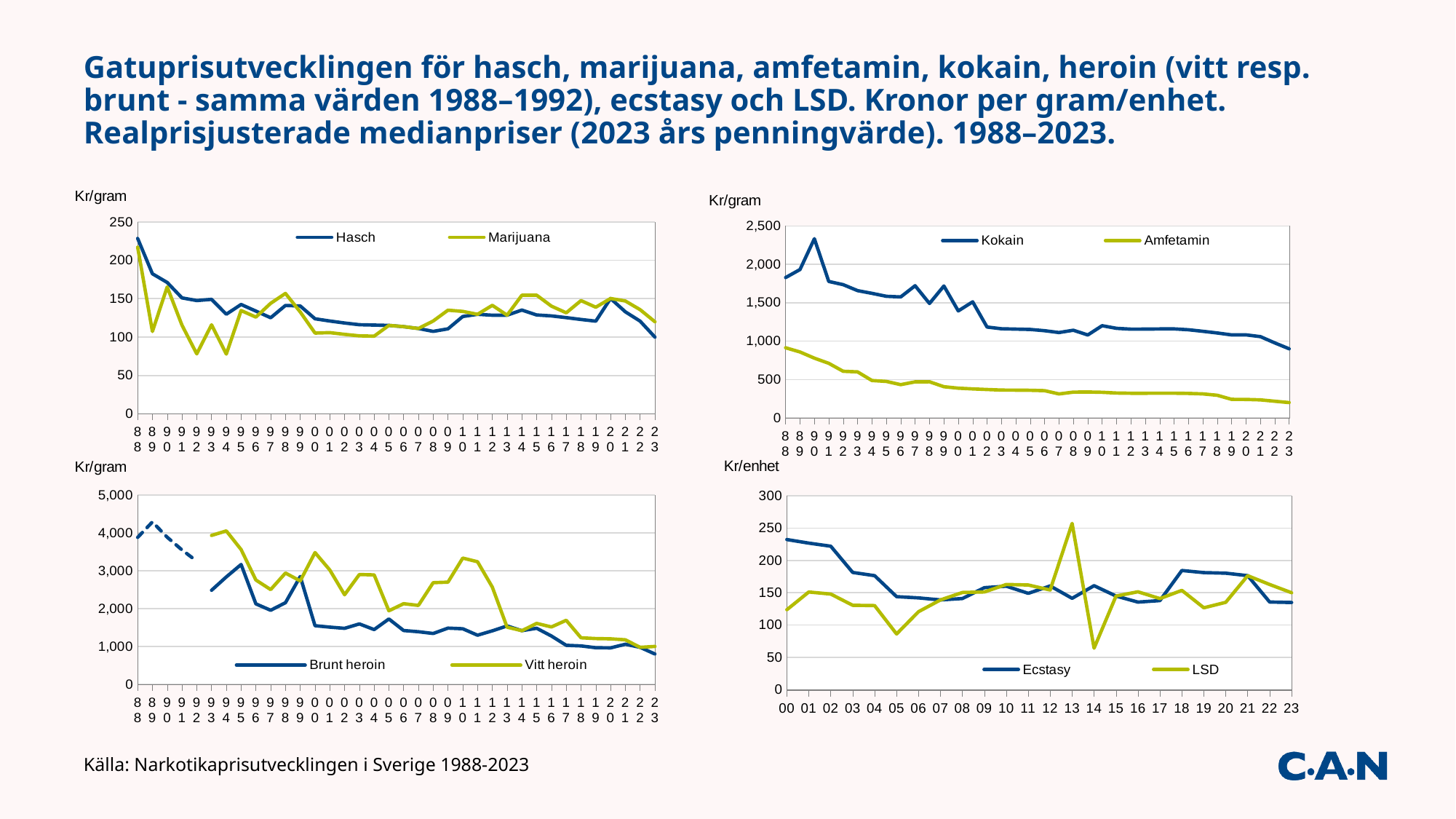
In the bottom-right chart, is the value for LSD in 2014 greater or less than 100? less In the top-left chart, is the value for Hasch in 1988 greater or less than 200? greater In the top-right chart, is the value for Kokain in 1989 greater or less than 2,000? less What kind of chart is the top-left chart showing Hasch and Marijuana? line chart In the top-right chart, which series has the larger value in 1988, Kokain or Amfetamin? Kokain In the bottom-right chart, how many years are plotted along the x axis? 24 In the top-right chart, does the Amfetamin line generally rise or fall from 1988 to 2023? fall What is the y-axis label of the bottom-right chart showing Ecstasy and LSD? Kr/enhet In the top-left chart, how many series does the legend list? 2